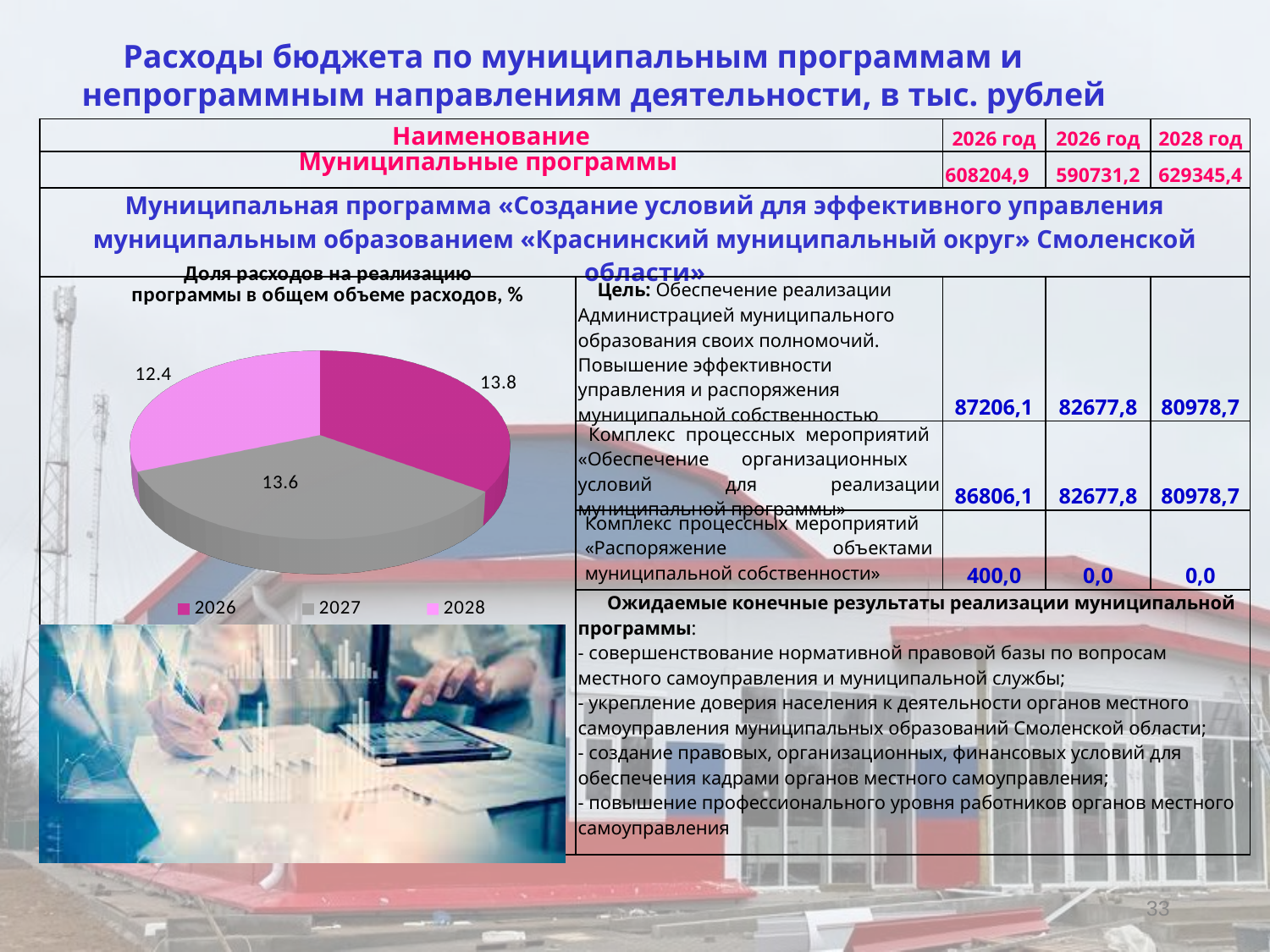
What is the value shown for 2028 in the pie chart? 12.4 Which is larger in the pie chart, the value for 2027 or the value for 2028? 2027 What type of chart is shown on the slide? pie chart Which year has the smallest value in the pie chart? 2028 Which colour represents 2027 in the pie chart legend? gray What is the value shown for 2027 in the pie chart? 13.6 What is the title of the pie chart? Доля расходов на реализацию программы в общем объеме расходов, % How many slices does the pie chart have? 3 How many entries does the pie chart legend list? 3 Which year has the largest value in the pie chart? 2026 What is the difference between the 2026 and 2028 values in the pie chart? 1.4 What is the value shown for 2026 in the pie chart? 13.8